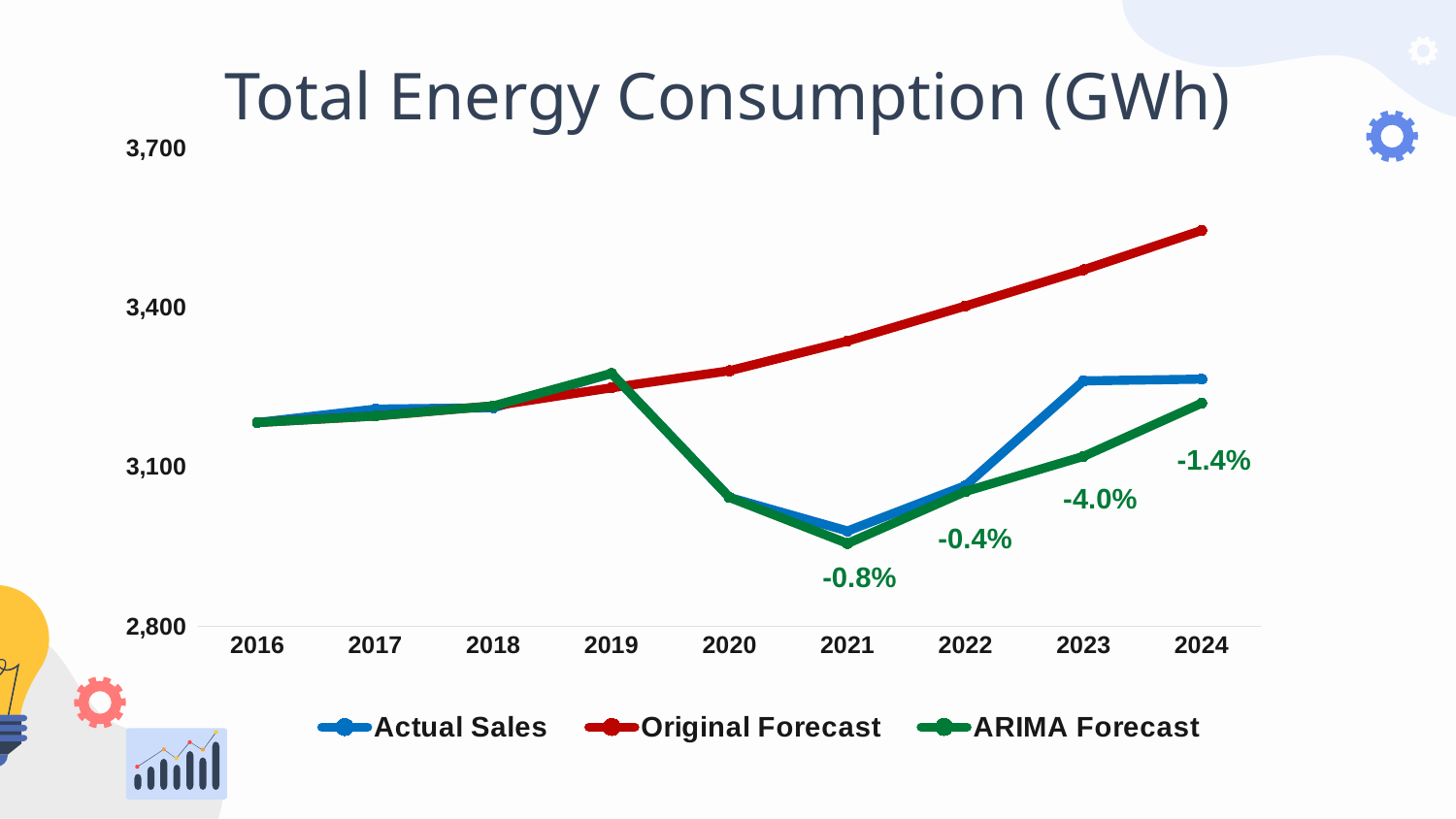
What percentage label is printed near the 2023 data point? -4.0% In 2024, which is larger: the Original Forecast or the Actual Sales value? Original Forecast How many series does the legend list? 3 Is the Actual Sales value for 2021 greater or less than 3,100? less How many years are shown on the x axis? 9 In which year is the Actual Sales value lowest? 2021 What percentage label is printed near the 2024 data point? -1.4% What kind of chart is shown on the slide? Line chart What percentage label is printed below the 2021 data point? -0.8% Does the Original Forecast line rise or fall from 2018 to 2024? Rises What is the title of the chart? Total Energy Consumption (GWh) Is the Original Forecast value for 2024 greater or less than 3,400? greater